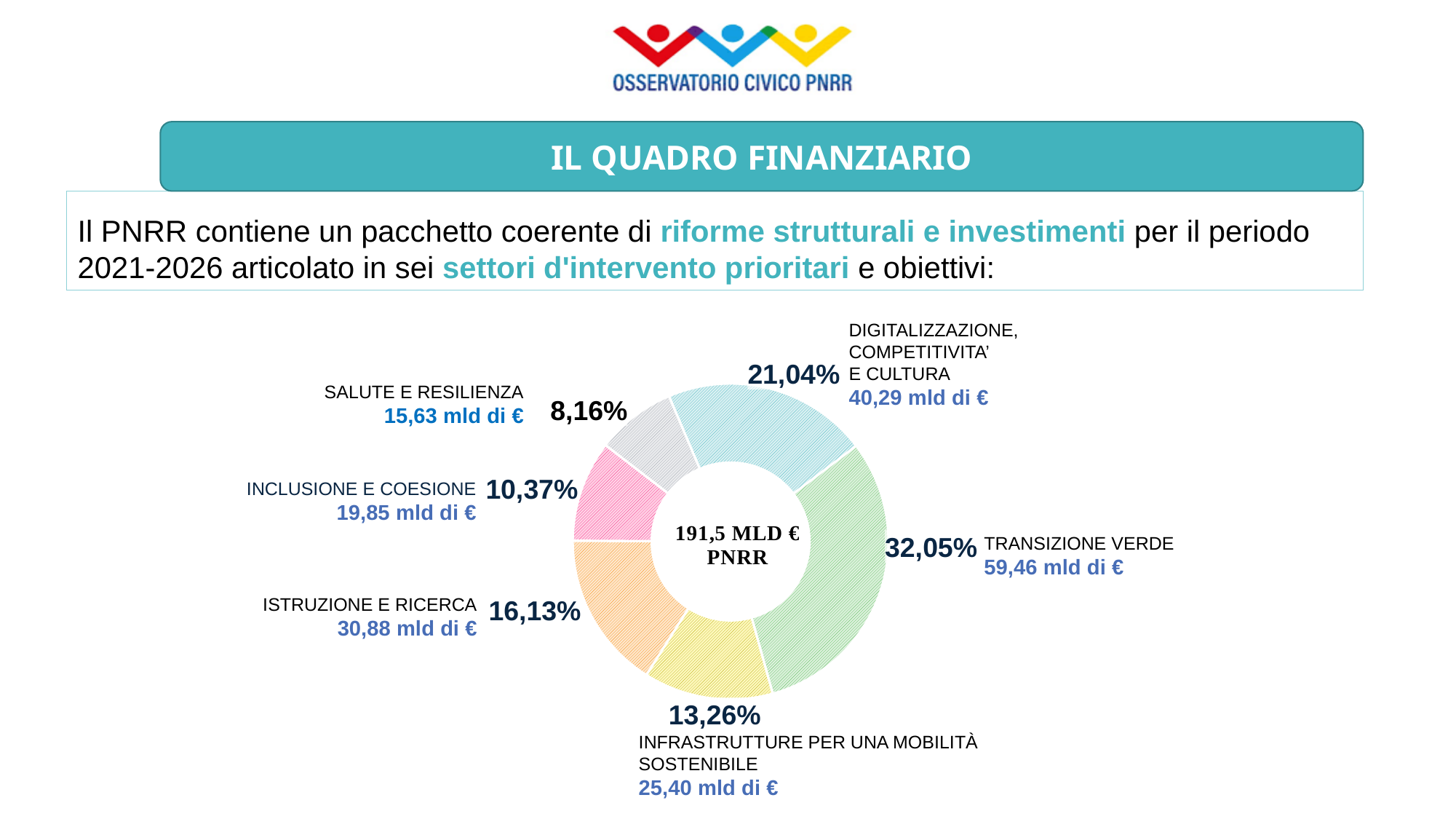
What kind of chart is shown on the slide? Donut chart How many sectors are shown in the chart? 6 What is the amount in mld di € for Istruzione e Ricerca? 30,88 mld di € Which is larger: Inclusione e Coesione or Infrastrutture per una Mobilità Sostenibile? Infrastrutture per una Mobilità Sostenibile What is the amount in mld di € for Digitalizzazione, Competitività e Cultura? 40,29 mld di € What total amount is written in the centre of the chart? 191,5 MLD € PNRR What is the difference in mld di € between Transizione Verde and Digitalizzazione, Competitività e Cultura? 19,17 mld di € Which sector has the smallest share of the PNRR? Salute e Resilienza What share of the PNRR does Salute e Resilienza represent? 8,16% Which sector has the largest share of the PNRR? Transizione Verde What share of the PNRR does Transizione Verde represent? 32,05% What is the difference in percentage points between the largest and smallest sectors? 23,89